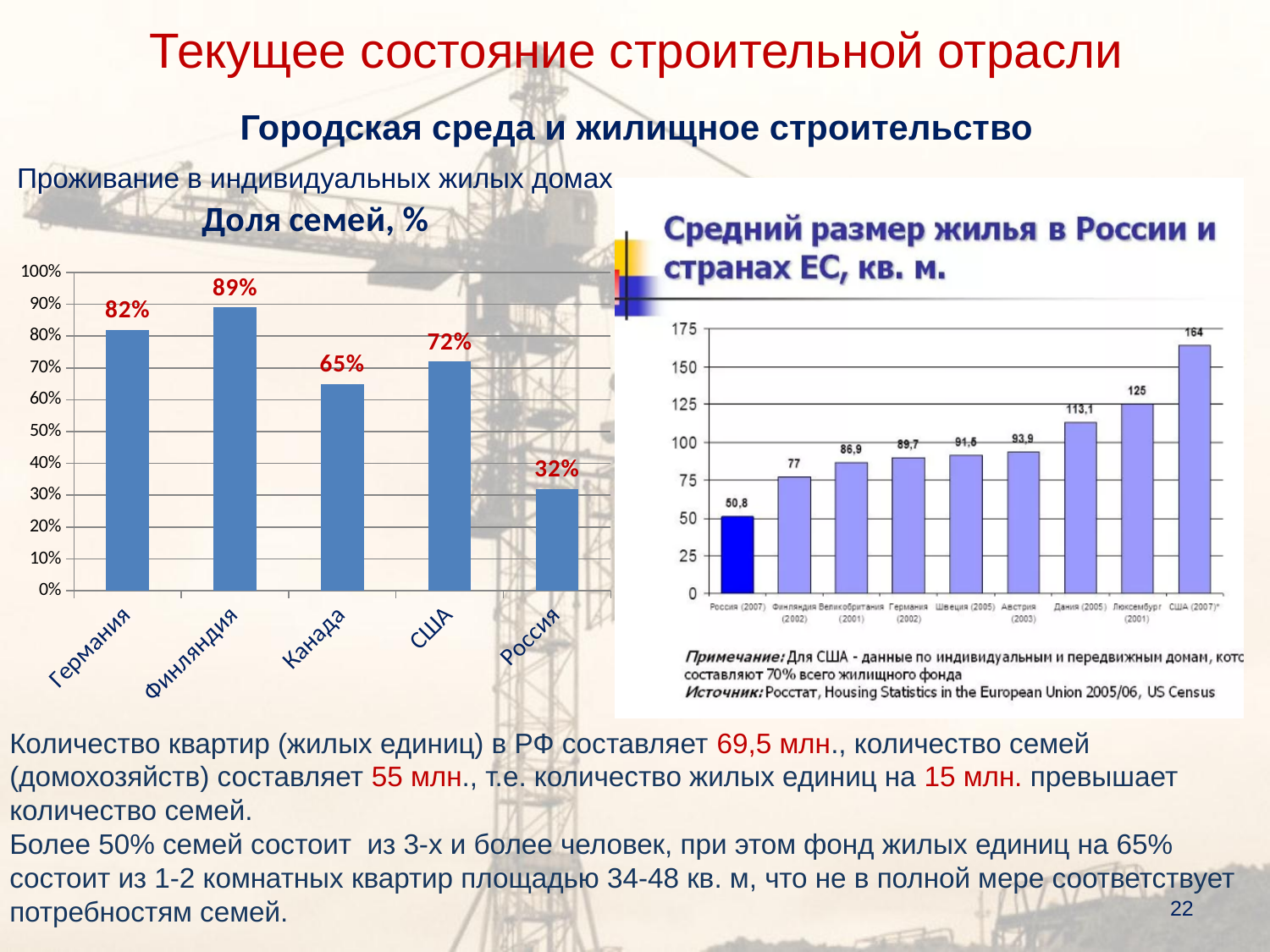
In the chart 'Средний размер жилья в России и странах ЕС, кв. м', which is larger: the value for Дания (2005) or Австрия (2003)? Дания (2005) In the chart 'Доля семей, %', how many categories are shown? 5 In the chart 'Доля семей, %', what is the difference between the values for Германия and США? 10% In the chart 'Средний размер жилья в России и странах ЕС, кв. м', what is the value for Люксембург (2001)? 125 In the chart 'Средний размер жилья в России и странах ЕС, кв. м', how many countries are shown? 9 In the chart 'Доля семей, %', what is the value for Финляндия? 89% In the chart 'Средний размер жилья в России и странах ЕС, кв. м', what is the value for Россия (2007)? 50,8 In the chart 'Доля семей, %', what is the value for Россия? 32% In the chart 'Доля семей, %', which category has the lowest value? Россия In the chart 'Средний размер жилья в России и странах ЕС, кв. м', which category has the highest value? США (2007) In the chart 'Доля семей, %', which category has the highest value? Финляндия What type of chart is the chart 'Доля семей, %'? Bar chart